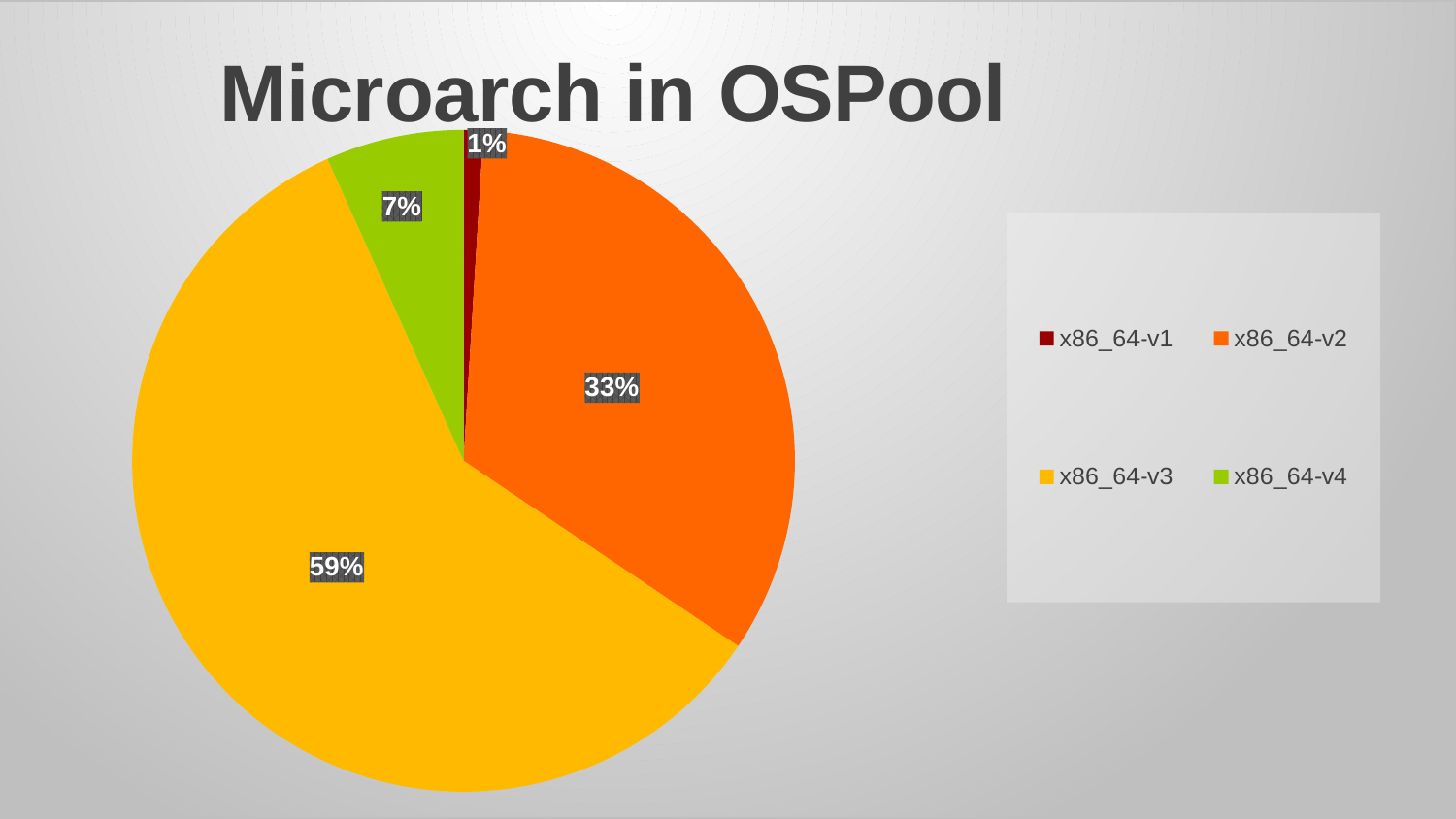
Which is larger, the share of x86_64-v4 or the share of x86_64-v1? x86_64-v4 What share of the pie does x86_64-v4 have? 7% Which category has the largest slice of the pie? x86_64-v3 What is the difference between the shares of x86_64-v3 and x86_64-v2? 26% How many categories does the pie chart show? 4 Which category has the smallest slice of the pie? x86_64-v1 What is the title of the chart? Microarch in OSPool What share of the pie does x86_64-v3 have? 59% What kind of chart is shown on the slide? pie chart What colour is the slice for x86_64-v4? green What share of the pie does x86_64-v2 have? 33%